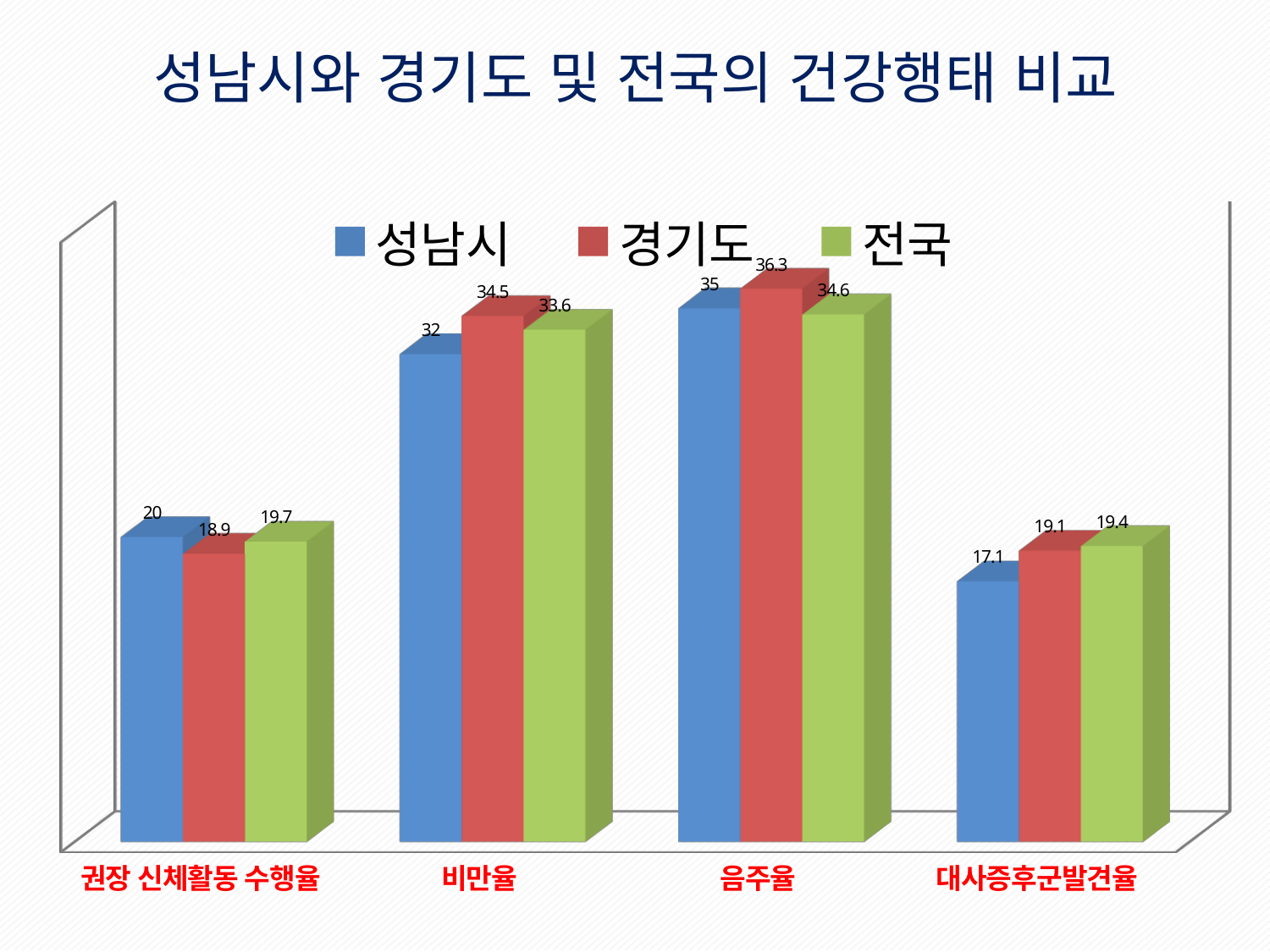
Which series has the highest value in the 음주율 category? 경기도 How many series does the legend list? 3 What is the value for 경기도 in the 음주율 category? 36.3 What is the difference between the 경기도 and 성남시 values in the 비만율 category? 2.5 What is the value for 경기도 in the 권장 신체활동 수행율 category? 18.9 What kind of chart is shown on the slide? bar chart How many categories are shown on the x axis? 4 What is the value for 성남시 in the 비만율 category? 32 Which series has the lowest value in the 대사증후군발견율 category? 성남시 Which is larger in the 권장 신체활동 수행율 category: the value for 성남시 or the value for 전국? 성남시 What is the title of the chart? 성남시와 경기도 및 전국의 건강행태 비교 What is the value for 전국 in the 대사증후군발견율 category? 19.4